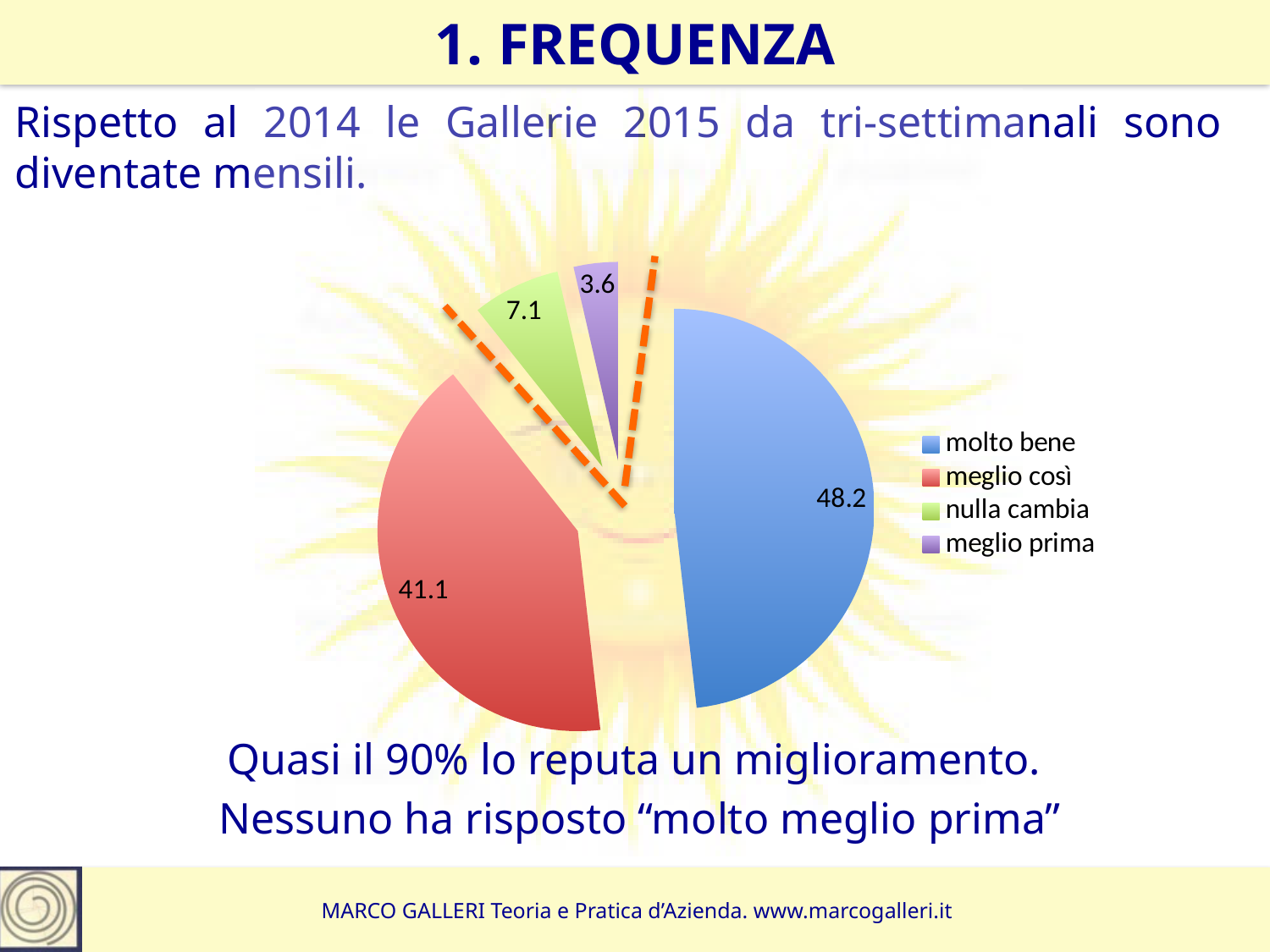
Which category has the largest slice in the pie chart? molto bene What is the difference between the values for "nulla cambia" and "meglio prima"? 3.5 Which category has the smallest slice in the pie chart? meglio prima Which colour represents "meglio così" in the pie chart? red What is the value for "meglio così" in the pie chart? 41.1 What kind of chart is shown on the slide? pie chart What is the value for "molto bene" in the pie chart? 48.2 What is the value for "nulla cambia" in the pie chart? 7.1 How many slices does the pie chart have? 4 Which is larger, the value for "nulla cambia" or the value for "meglio prima"? nulla cambia What is the value for "meglio prima" in the pie chart? 3.6 What is the difference between the values for "molto bene" and "meglio così"? 7.1